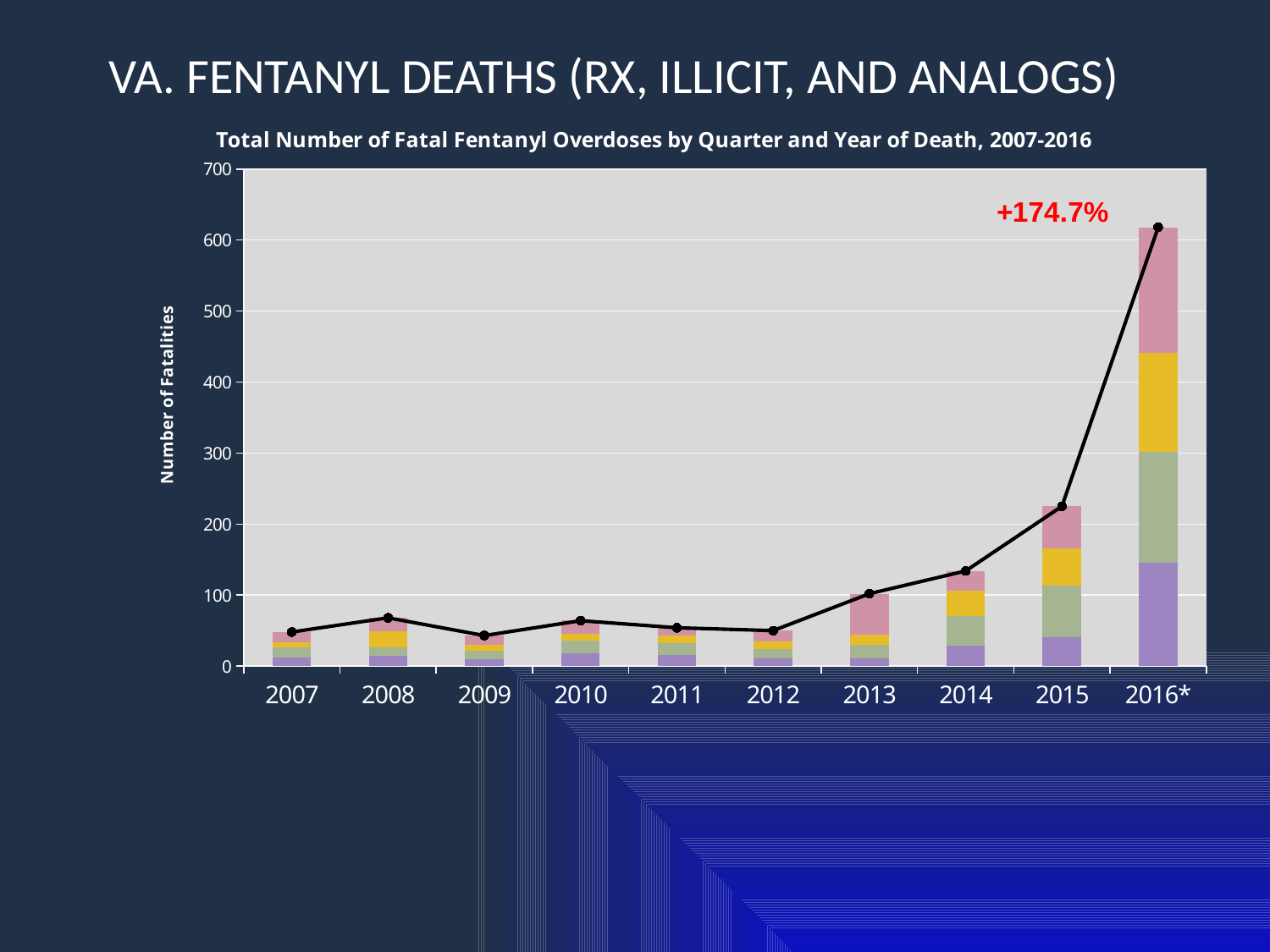
Which year has more fatalities, 2015 or 2016*? 2016* What percentage change is annotated in red on the chart? +174.7% Which year has the highest total number of fatal fentanyl overdoses? 2016* Is the total number of fatalities for 2015 greater or less than 200? greater What kind of chart is shown on the slide? Stacked bar chart with a line overlay How many years are shown along the x axis of the chart? 10 What is the label on the vertical axis of the chart? Number of Fatalities Which year has more fatalities, 2008 or 2009? 2008 Is the total number of fatalities for 2016* greater or less than 500? greater Is the total number of fatalities for 2014 greater or less than 100? greater Do the total fatalities rise or fall from 2013 to 2016*? rise